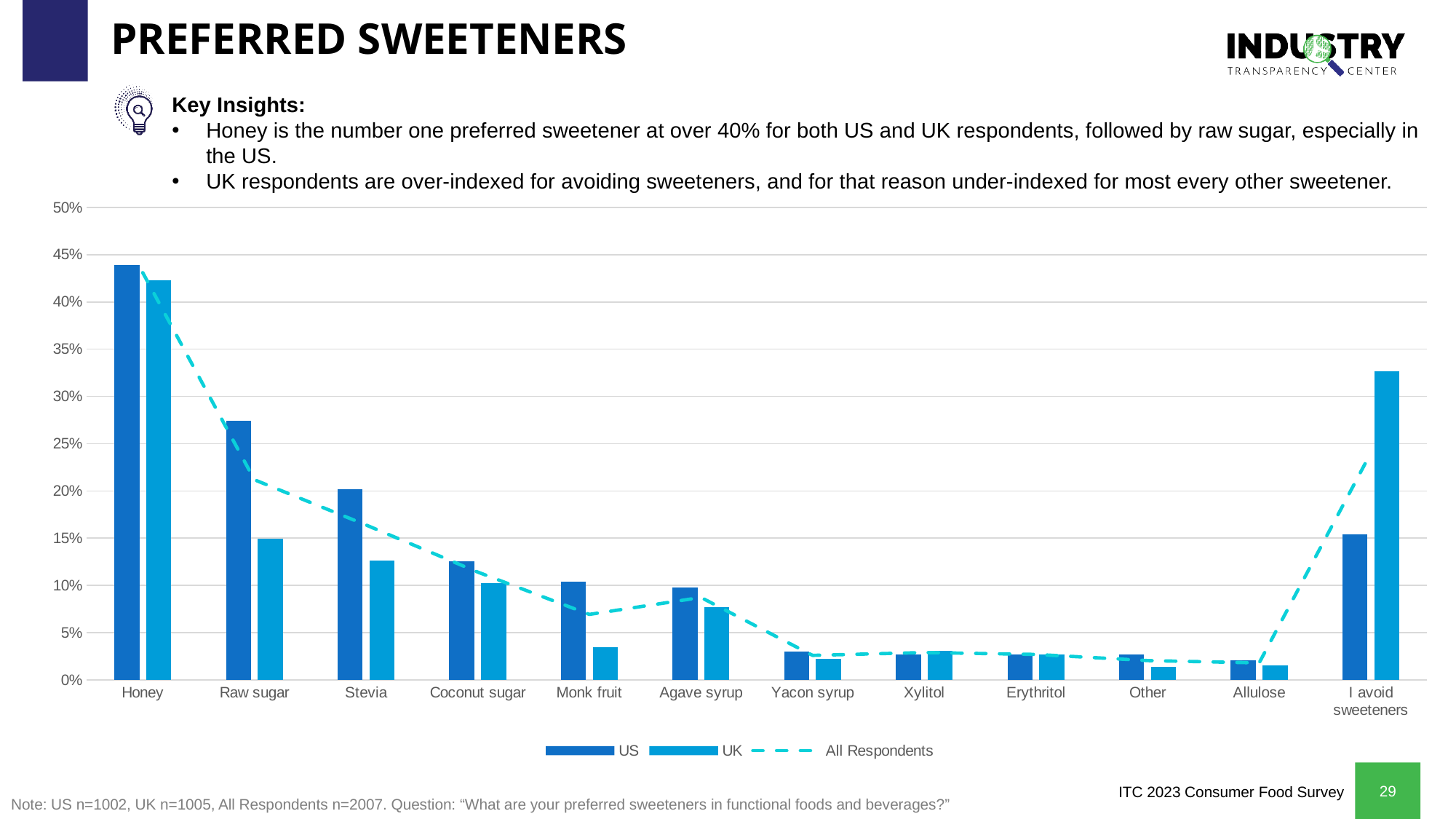
How many series does the legend list? 3 Is the UK value for I avoid sweeteners greater or less than 30%? greater Is the US value for Raw sugar greater or less than 25%? greater How many sweetener categories are shown on the x axis? 12 For I avoid sweeteners, which is larger, the US value or the UK value? UK Does the All Respondents line rise or fall from Honey to Stevia? fall Which category has the highest UK value? Honey For Raw sugar, which is larger, the US value or the UK value? US What kind of chart is shown on the slide? bar chart with a dashed line Which category has the highest US value? Honey Is the UK value for Monk fruit greater or less than 5%? less